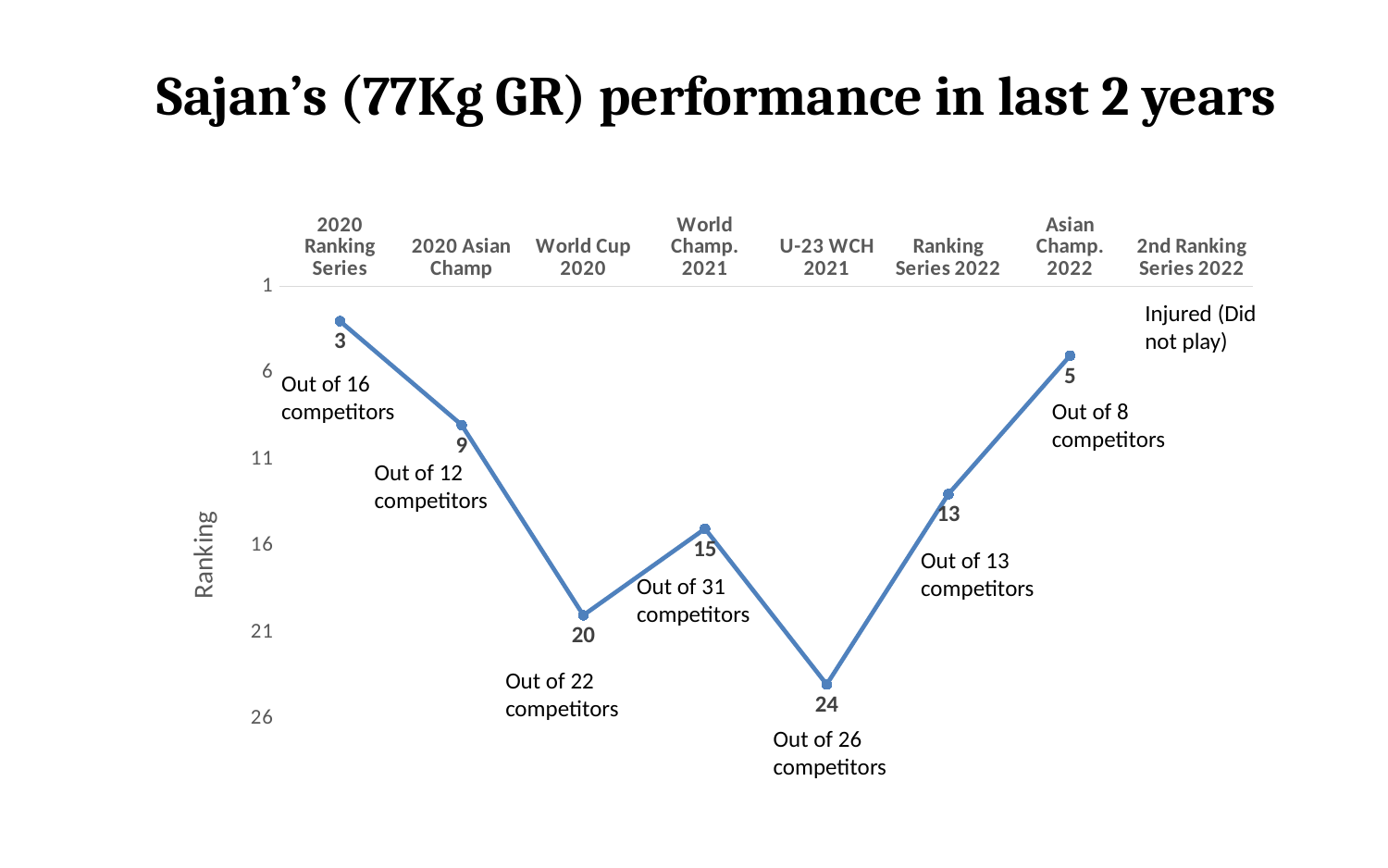
What is the title of the chart? Sajan's (77Kg GR) performance in last 2 years What is the difference between the ranking at the U-23 WCH 2021 and the ranking at the World Champ. 2021? 9 What ranking is shown for the U-23 WCH 2021? 24 What type of chart is shown on the slide? line chart How many data points are plotted on the line? 7 Which has the larger ranking number, the 2020 Asian Champ or the Ranking Series 2022? Ranking Series 2022 Does the ranking number rise or fall from the 2020 Ranking Series to the World Cup 2020? rise What ranking did Sajan achieve at the World Cup 2020? 20 What ranking is shown for the Asian Champ. 2022? 5 Why is there no data point for the 2nd Ranking Series 2022? Injured (Did not play) At which event is the smallest ranking number plotted? 2020 Ranking Series At which event is the largest ranking number plotted? U-23 WCH 2021